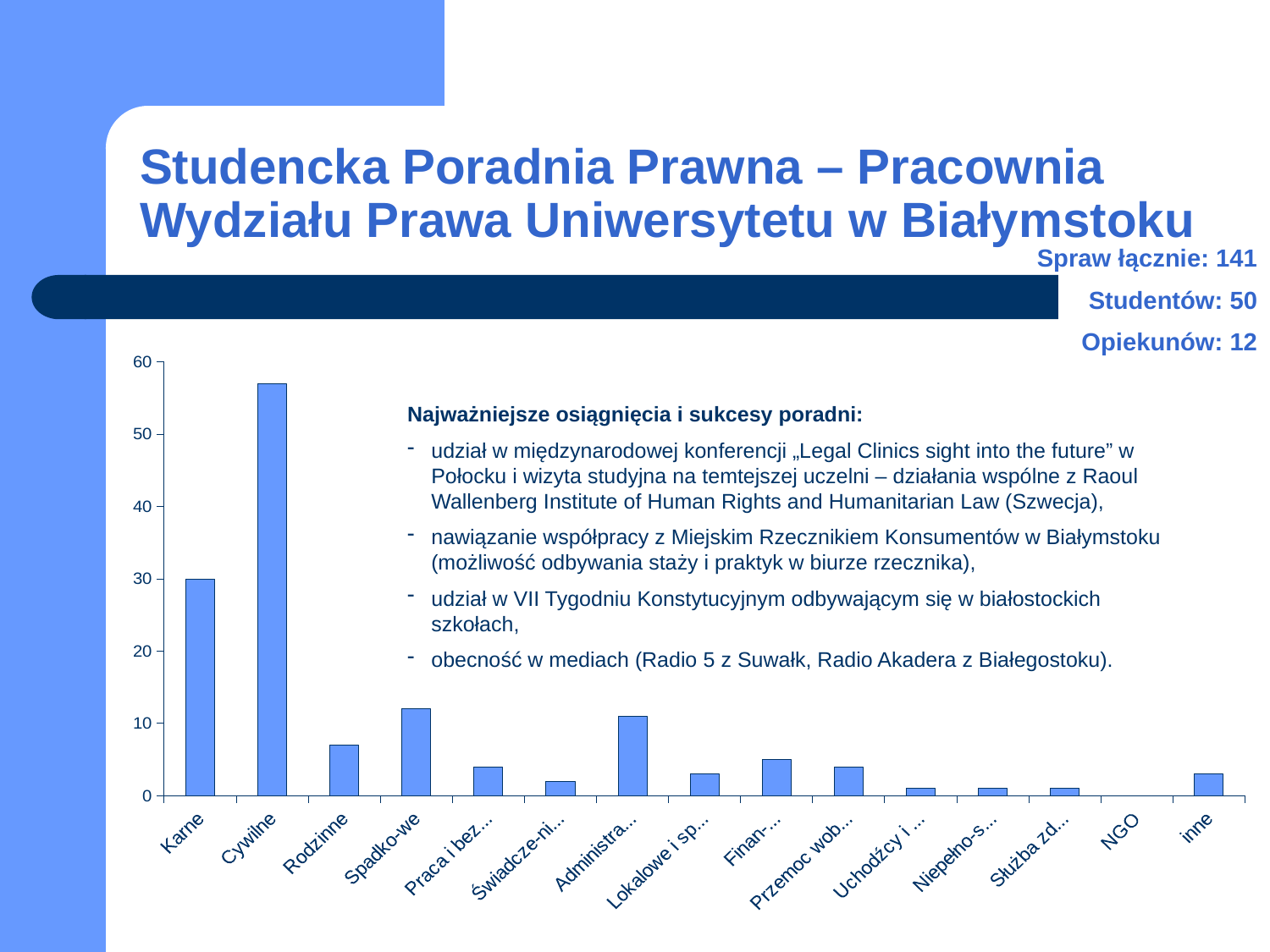
Is the value for Rodzinne greater or less than 10? less How many categories are shown on the x axis of the chart? 15 Which is larger, the value for Karne or the value for Rodzinne? Karne Is the value for Spadko-we greater or less than 10? greater What is the value for Karne in the chart? 30 Is the value for Administra... greater or less than 20? less What is the highest value shown on the y axis of the chart? 60 Which is larger, the value for Cywilne or the value for Karne? Cywilne Which category has the lowest bar in the chart? NGO What kind of chart is shown on the slide? bar chart Which category has the highest bar in the chart? Cywilne